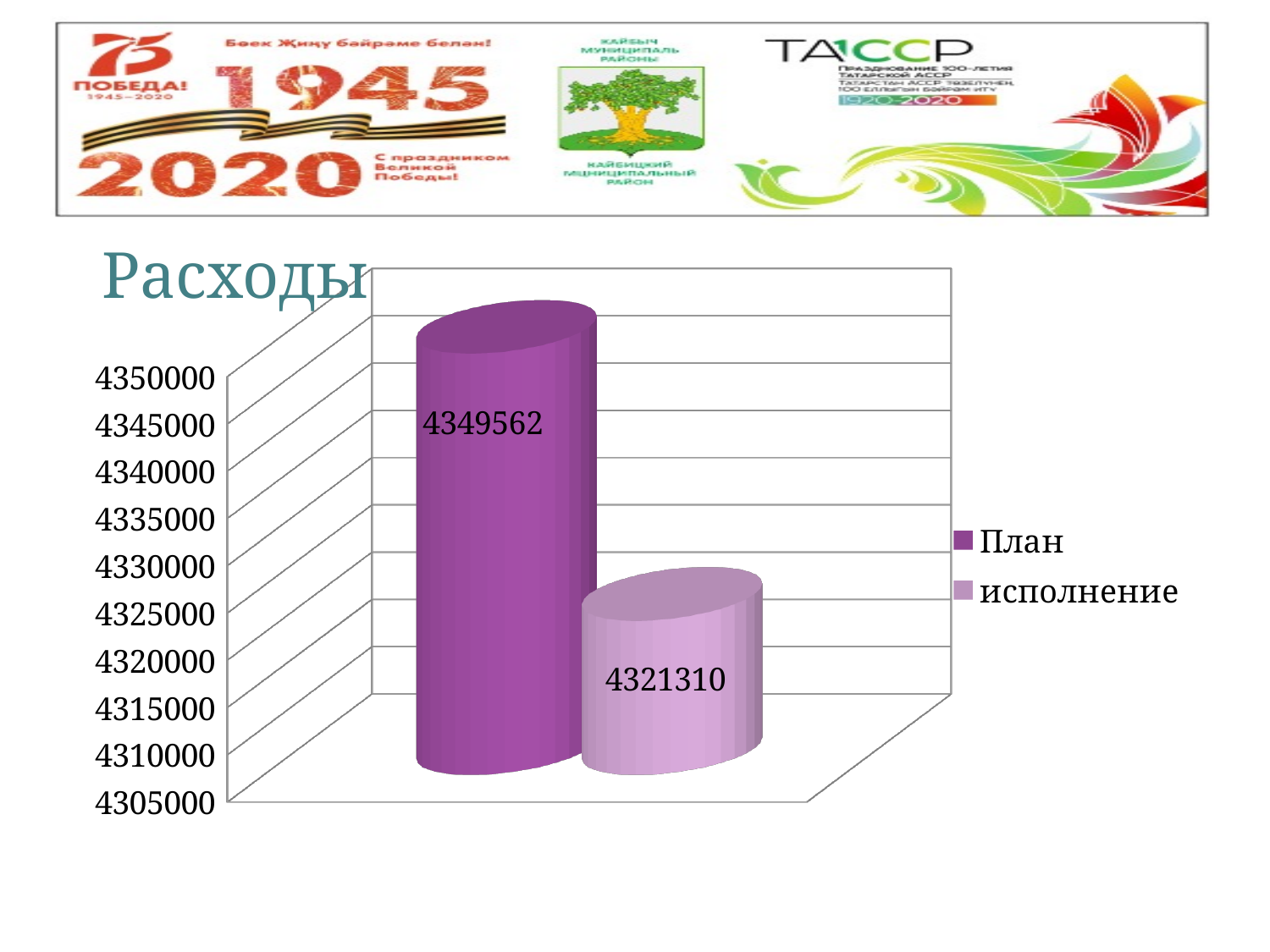
Which series has the lowest value? исполнение What is the difference between the План value and the исполнение value? 28252 What is the value for План? 4349562 Is the value for исполнение greater or less than 4325000? less Is the value for План greater or less than 4345000? greater How many bars are plotted on the chart? 2 Which series has the higher value, План or исполнение? План How many series does the legend list? 2 What is the title of the chart? Расходы What is the value for исполнение? 4321310 Which series has the highest value? План What kind of chart is shown on the slide? bar chart